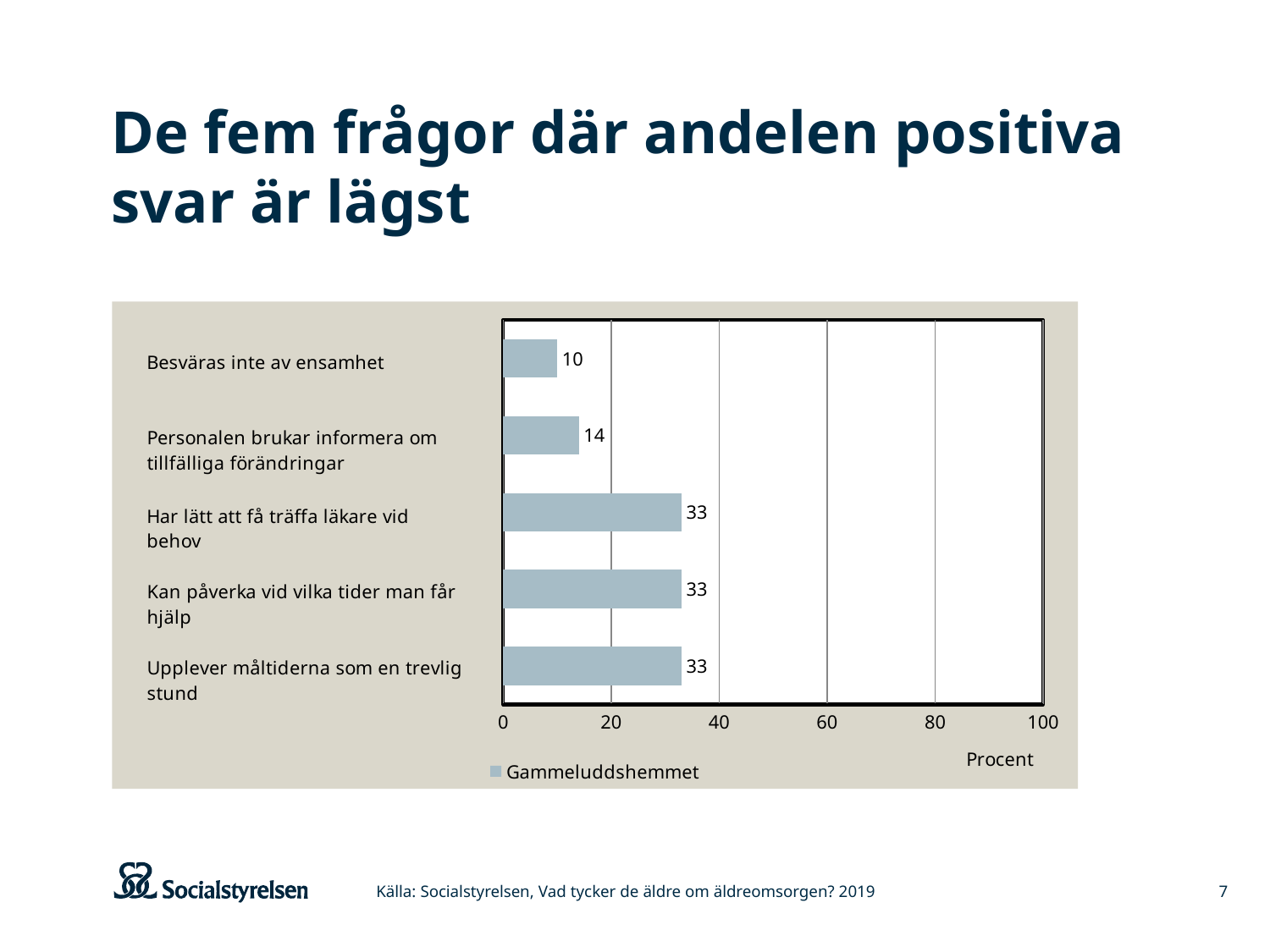
How many categories are shown in the chart? 5 What is the value for "Har lätt att få träffa läkare vid behov"? 33 What is the difference between the values for "Kan påverka vid vilka tider man får hjälp" and "Besväras inte av ensamhet"? 23 Which is larger, the value for "Upplever måltiderna som en trevlig stund" or the value for "Personalen brukar informera om tillfälliga förändringar"? Upplever måltiderna som en trevlig stund Which category has the lowest value? Besväras inte av ensamhet What is the value for "Besväras inte av ensamhet"? 10 Is the value for "Har lätt att få träffa läkare vid behov" greater or less than 40? less What series name is shown in the legend? Gammeluddshemmet What kind of chart is shown on the slide? bar chart How many series does the legend list? 1 What is the value for "Personalen brukar informera om tillfälliga förändringar"? 14 What is the difference between the values for "Personalen brukar informera om tillfälliga förändringar" and "Besväras inte av ensamhet"? 4